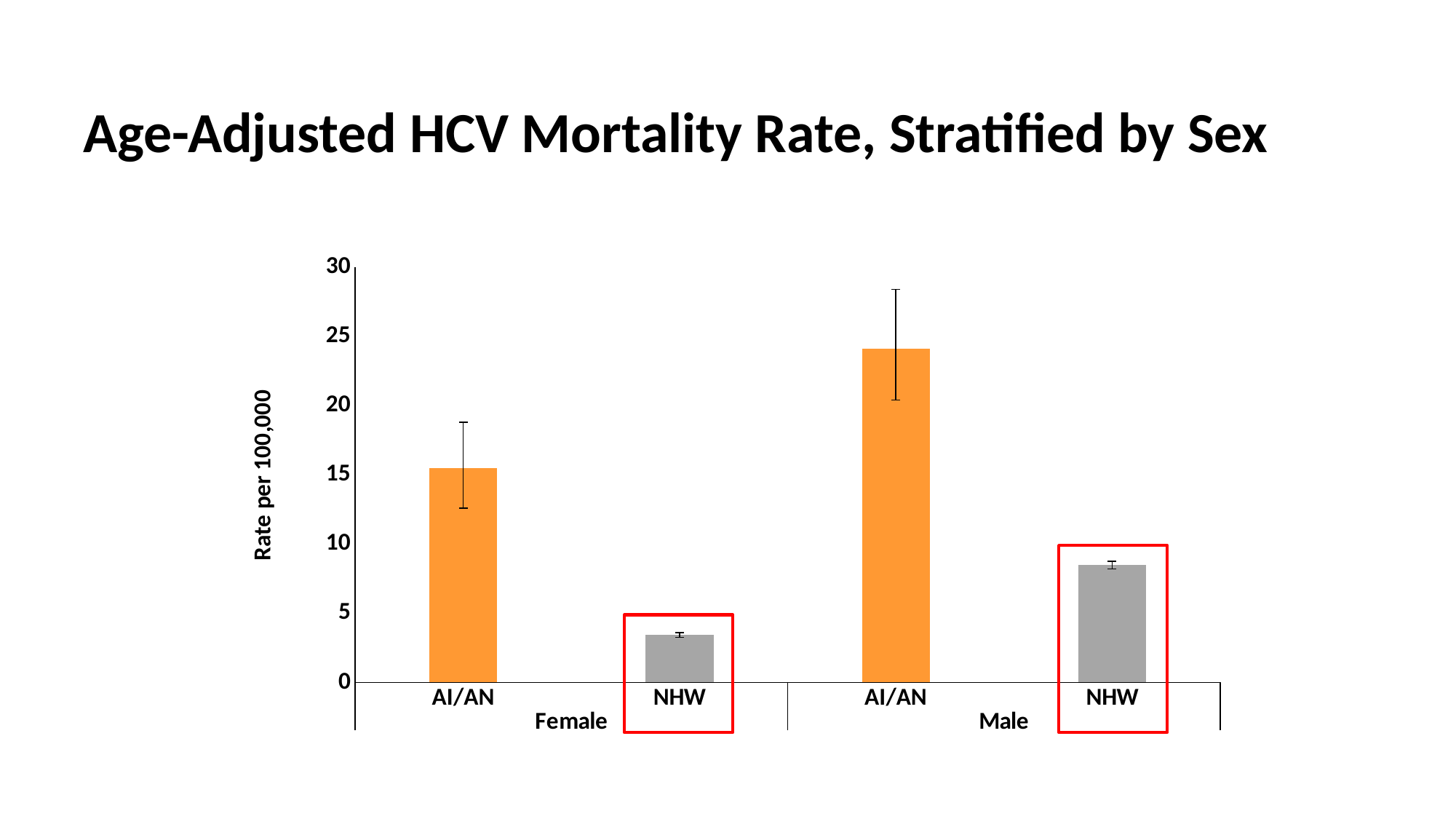
Is the value for Male AI/AN greater or less than 20? greater How many bars are plotted in the chart? 4 What is the label on the vertical axis of the chart? Rate per 100,000 Is the value for Female NHW greater or less than 5? less What is the title of the chart? Age-Adjusted HCV Mortality Rate, Stratified by Sex Is the value for Male NHW greater or less than 10? less Which is larger, the value for Female AI/AN or the value for Male AI/AN? Male AI/AN Which is larger, the value for Male NHW or the value for Female NHW? Male NHW Which bar has the lowest value in the chart? Female NHW What type of chart is shown on the slide? bar chart Which bar has the highest value in the chart? Male AI/AN